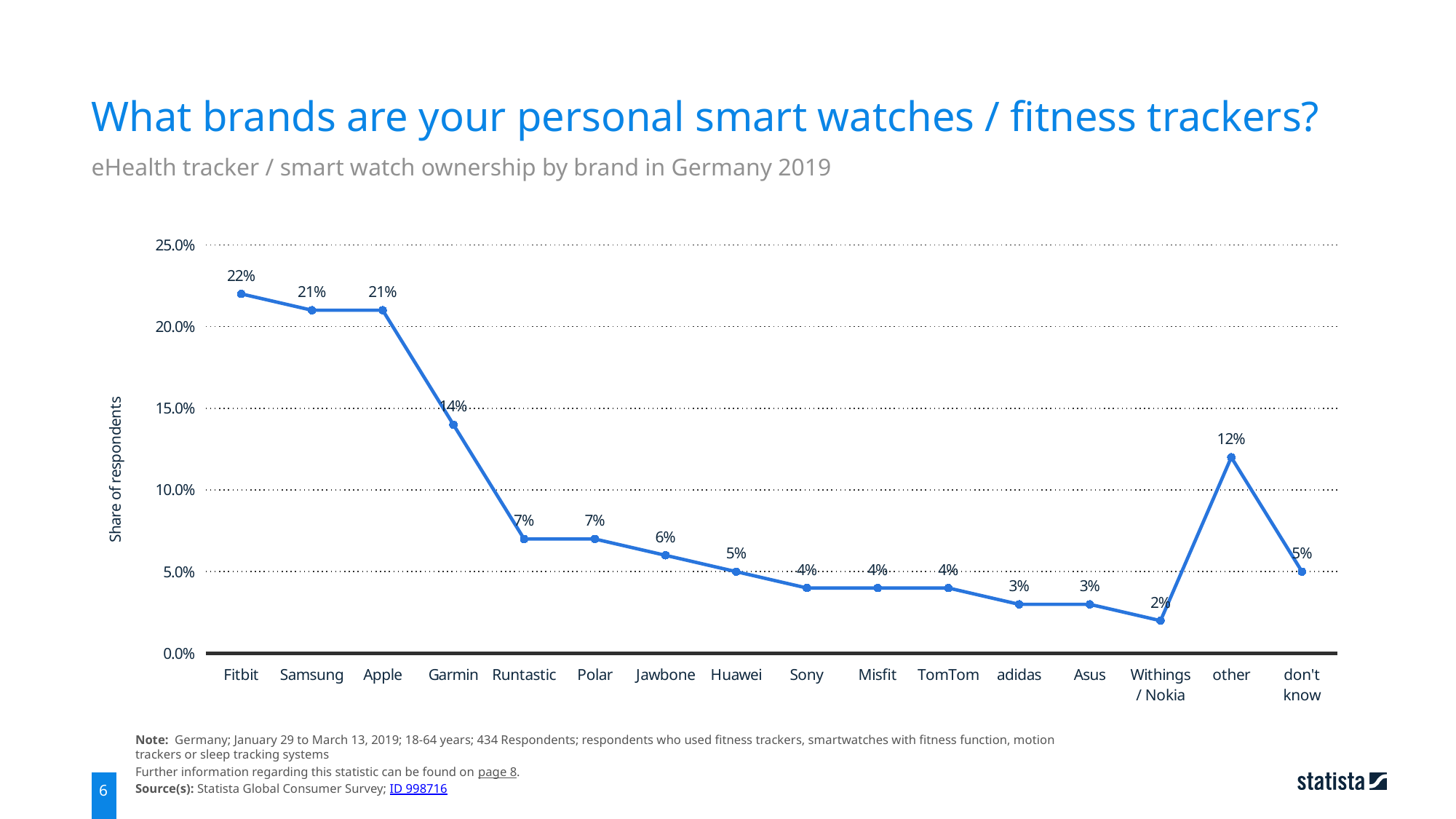
What is the value for Fitbit? 22% Which category has the lowest share of respondents? Withings / Nokia What is the difference between the values for Fitbit and Garmin? 8% What kind of chart is shown on the slide? Line chart Do the values generally rise or fall from Fitbit to Withings / Nokia? Fall Which brand has the highest share of respondents? Fitbit What is the value for Garmin? 14% How many categories are plotted on the x axis? 16 What is the label of the y axis? Share of respondents What is the value for 'other'? 12% What is the value for Withings / Nokia? 2% Which is larger, the value for Jawbone or the value for Huawei? Jawbone